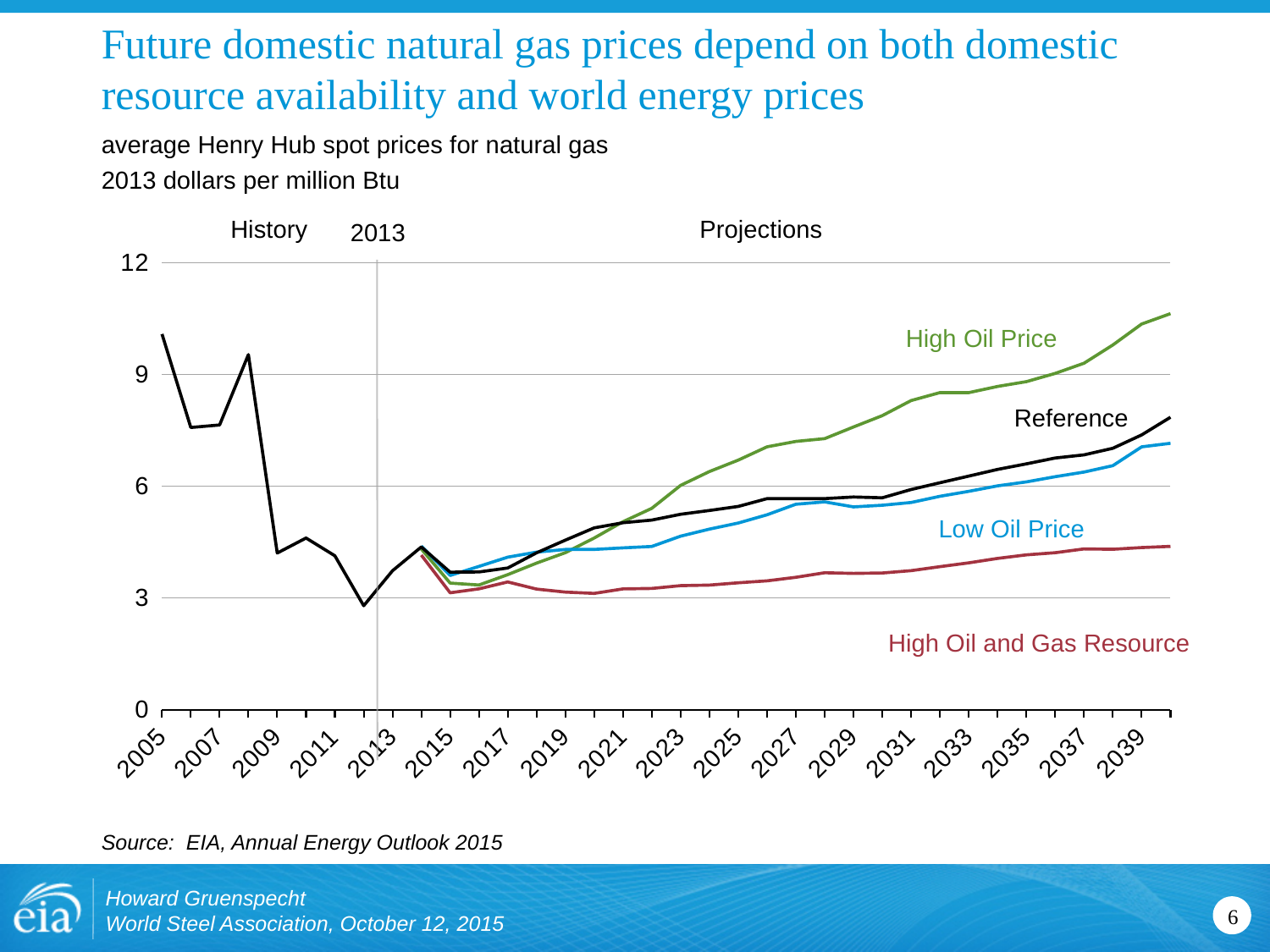
What kind of chart is shown on the slide? line chart Does the High Oil Price line rise or fall from 2020 to 2039? rise What year does the vertical line separating History from Projections mark? 2013 Is the value for High Oil and Gas Resource in 2039 greater or less than 6? less Is the value for High Oil Price in 2039 greater or less than 9? greater Is the value for Reference in 2039 greater or less than 6? greater In 2035, which is larger: the High Oil Price value or the Reference value? High Oil Price Which series has the highest value in 2039? High Oil Price How many projection series (labelled lines) are shown in the chart? 4 Which series has the lowest value in 2039? High Oil and Gas Resource